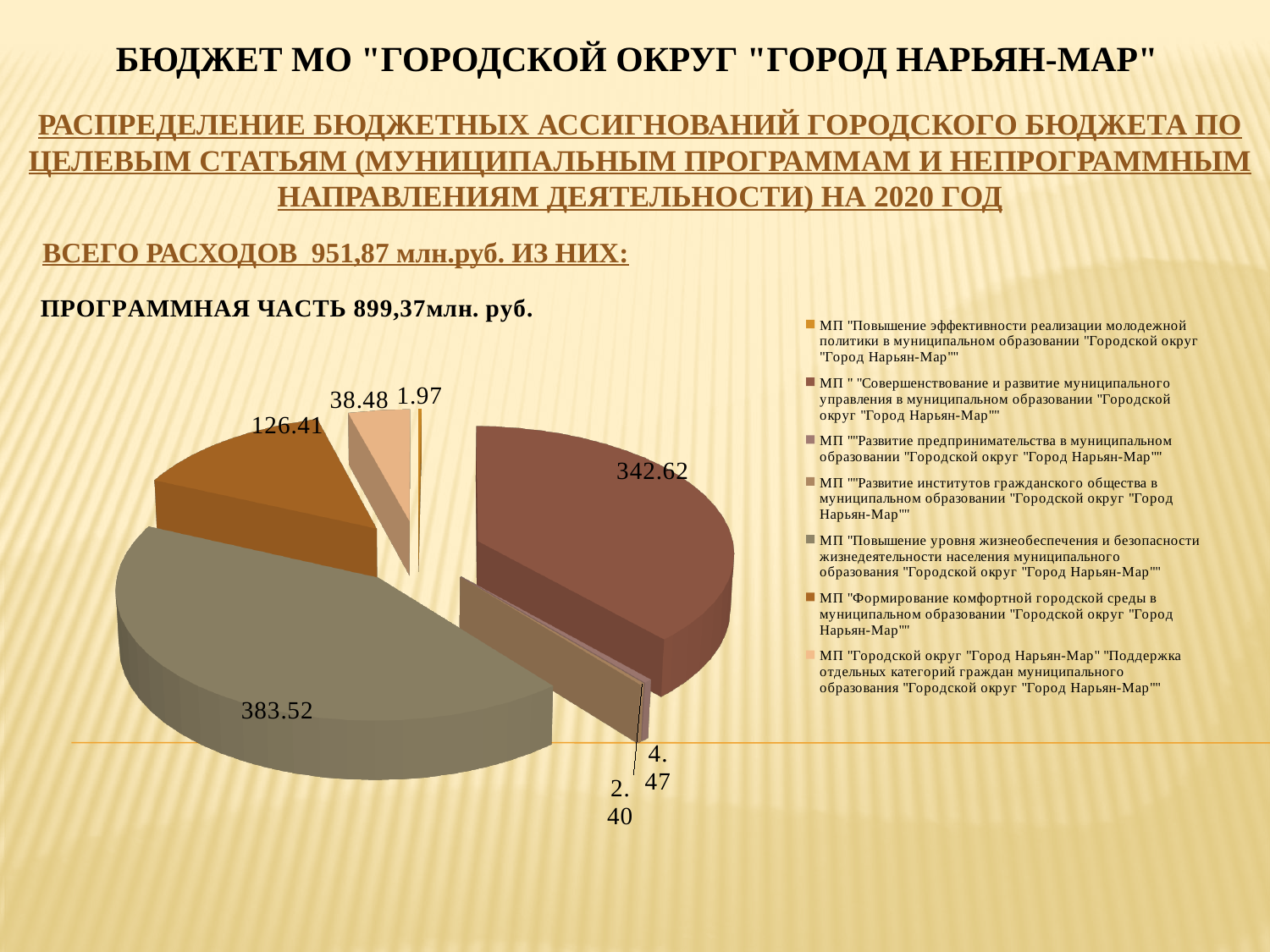
What kind of chart is shown on the slide? pie chart Which programme has the largest slice of the pie chart? МП "Повышение уровня жизнеобеспечения и безопасности жизнедеятельности населения муниципального образования "Городской округ "Город Нарьян-Мар"" What is the value for МП "Совершенствование и развитие муниципального управления в муниципальном образовании "Городской округ "Город Нарьян-Мар""? 342.62 What is the heading printed above the pie chart? ПРОГРАММНАЯ ЧАСТЬ 899,37млн. руб. How many entries does the legend of the pie chart list? 7 What is the value for МП "Городской округ "Город Нарьян-Мар" "Поддержка отдельных категорий граждан муниципального образования "Городской округ "Город Нарьян-Мар""? 38.48 How many slices does the pie chart have? 7 What is the smallest value shown on the pie chart? 1.97 What is the largest value shown on the pie chart? 383.52 Which is larger: the slice labelled 126.41 or the slice labelled 38.48? 126.41 What is the value for МП "Формирование комфортной городской среды в муниципальном образовании "Городской округ "Город Нарьян-Мар""? 126.41 What is the difference between the two largest slices, 383.52 and 342.62? 40.90